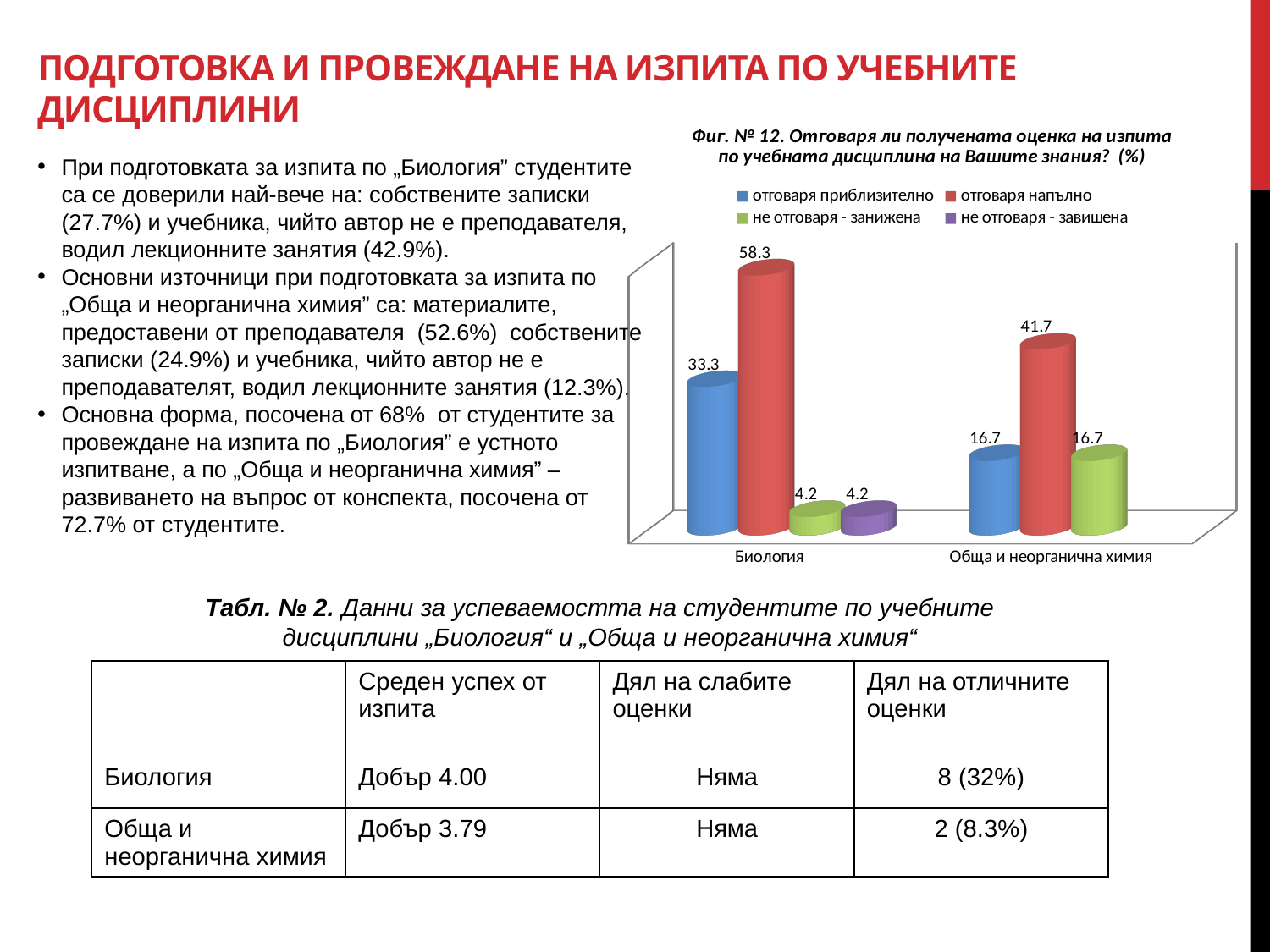
What is the difference between "отговаря напълно" for "Биология" and "отговаря напълно" for "Обща и неорганична химия"? 16.6 Which colour represents the "отговаря напълно" series in the chart? Red What type of chart is shown in Фиг. № 12? Bar chart Which is larger: "отговаря напълно" for "Биология" or "отговаря напълно" for "Обща и неорганична химия"? Биология Which series has the highest value in the "Обща и неорганична химия" category? отговаря напълно What is the value for "отговаря напълно" in the "Биология" category? 58.3 How many series does the legend of the chart list? 4 What is the value for "отговаря приблизително" in the "Обща и неорганична химия" category? 16.7 How many categories are shown on the x axis of the chart? 2 What is the difference between "отговаря напълно" and "отговаря приблизително" in the "Биология" category? 25 What is the value for "не отговаря - завишена" in the "Биология" category? 4.2 What is the value for "не отговаря - занижена" in the "Биология" category? 4.2